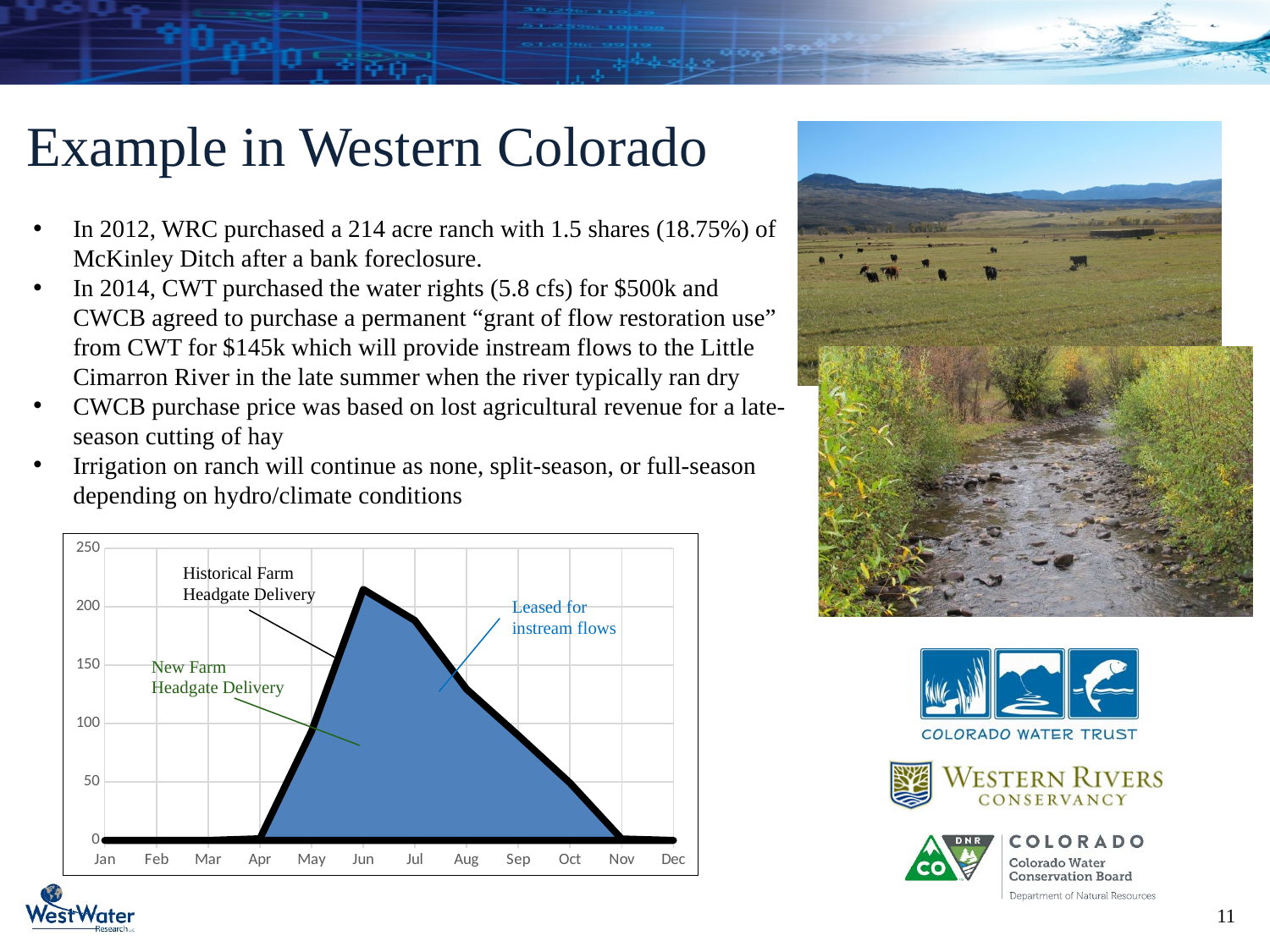
What is the Historical Farm Headgate Delivery value for Dec? 0 What is the highest value shown on the chart's y axis? 250 Which month has the larger Historical Farm Headgate Delivery, Jul or Sep? Jul Is the Historical Farm Headgate Delivery value for Jun greater or less than 200? greater How many months are shown along the x axis of the chart? 12 What is the Historical Farm Headgate Delivery value for Jan? 0 In which month does the Historical Farm Headgate Delivery reach its highest value? Jun Is the Historical Farm Headgate Delivery value for Jul greater or less than 150? greater Is the Historical Farm Headgate Delivery value for Sep greater or less than 100? less Does the Historical Farm Headgate Delivery rise or fall from Jun to Nov? fall What kind of chart is shown on the slide? area chart